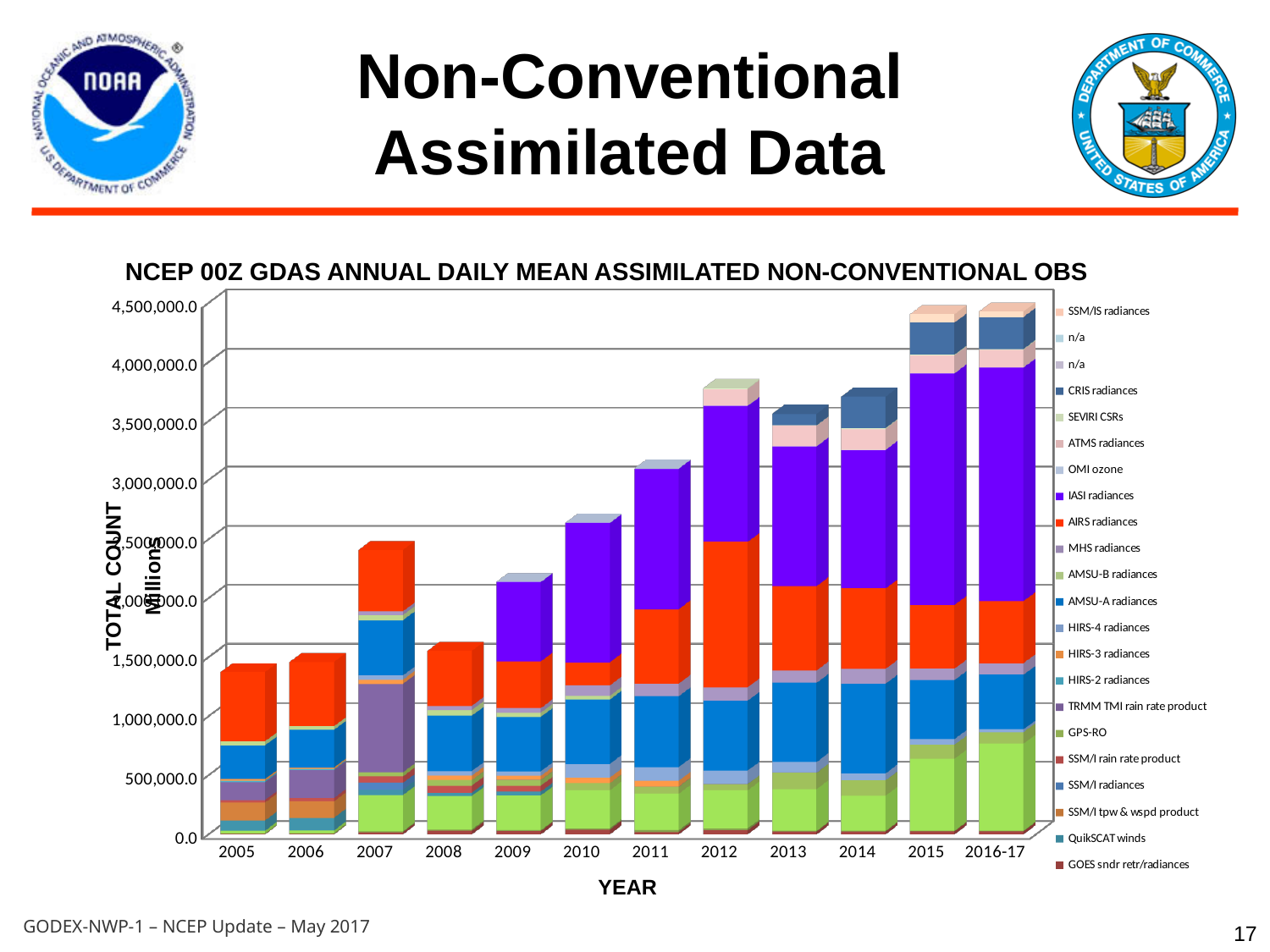
Which year has a larger total stacked value, 2010 or 2011? 2011 What kind of chart is shown on the slide? Stacked bar chart Is the total stacked value for 2015 greater or less than 4,000,000.0? greater How many entries does the chart's legend list? 22 What is the label of the x axis? YEAR Is the total stacked value for 2012 greater or less than 3,500,000.0? greater Is the total stacked value for 2005 greater or less than 1,500,000.0? less Overall, do the total stacked values rise or fall from 2005 to 2016-17? rise What is the title of the chart? NCEP 00Z GDAS ANNUAL DAILY MEAN ASSIMILATED NON-CONVENTIONAL OBS How many year categories are shown on the x axis of the chart? 12 Which year has a larger total stacked value, 2007 or 2008? 2007